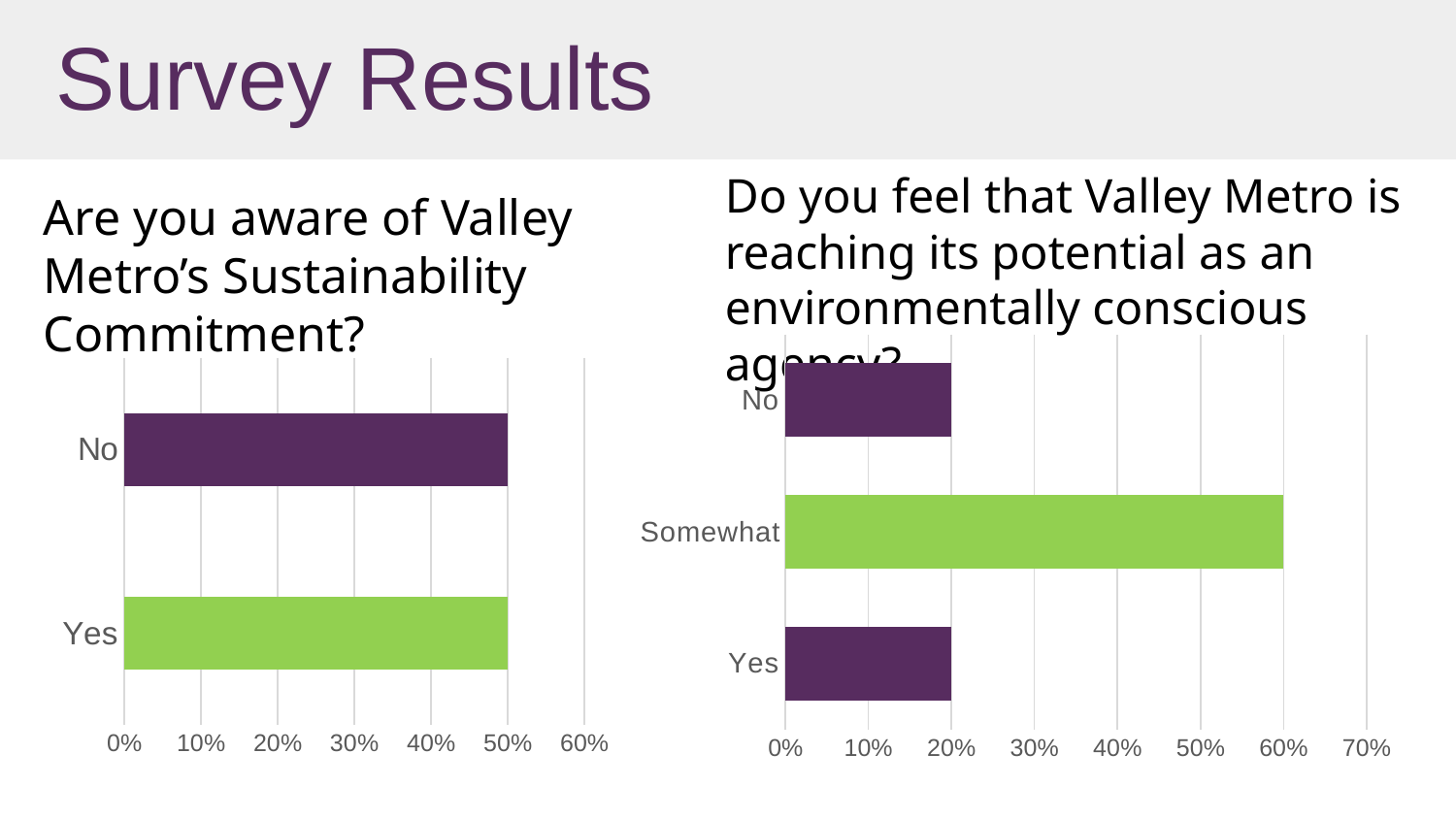
In the right chart (Do you feel that Valley Metro is reaching its potential as an environmentally conscious agency?), what is the difference between the values for Somewhat and Yes? 40% In the left chart (Are you aware of Valley Metro's Sustainability Commitment?), how many categories are shown? 2 In the right chart (Do you feel that Valley Metro is reaching its potential as an environmentally conscious agency?), what colour is the Somewhat bar? Green In the left chart (Are you aware of Valley Metro's Sustainability Commitment?), what is the value for No? 50% In the left chart (Are you aware of Valley Metro's Sustainability Commitment?), what is the value for Yes? 50% In the right chart (Do you feel that Valley Metro is reaching its potential as an environmentally conscious agency?), which category has the highest value? Somewhat In the right chart (Do you feel that Valley Metro is reaching its potential as an environmentally conscious agency?), what is the value for Yes? 20% In the right chart (Do you feel that Valley Metro is reaching its potential as an environmentally conscious agency?), how many categories are shown? 3 In the right chart (Do you feel that Valley Metro is reaching its potential as an environmentally conscious agency?), what is the value for No? 20% In the right chart (Do you feel that Valley Metro is reaching its potential as an environmentally conscious agency?), which is larger, the value for Somewhat or the value for No? Somewhat What kind of chart is the left chart (Are you aware of Valley Metro's Sustainability Commitment?)? Bar chart In the right chart (Do you feel that Valley Metro is reaching its potential as an environmentally conscious agency?), what is the value for Somewhat? 60%